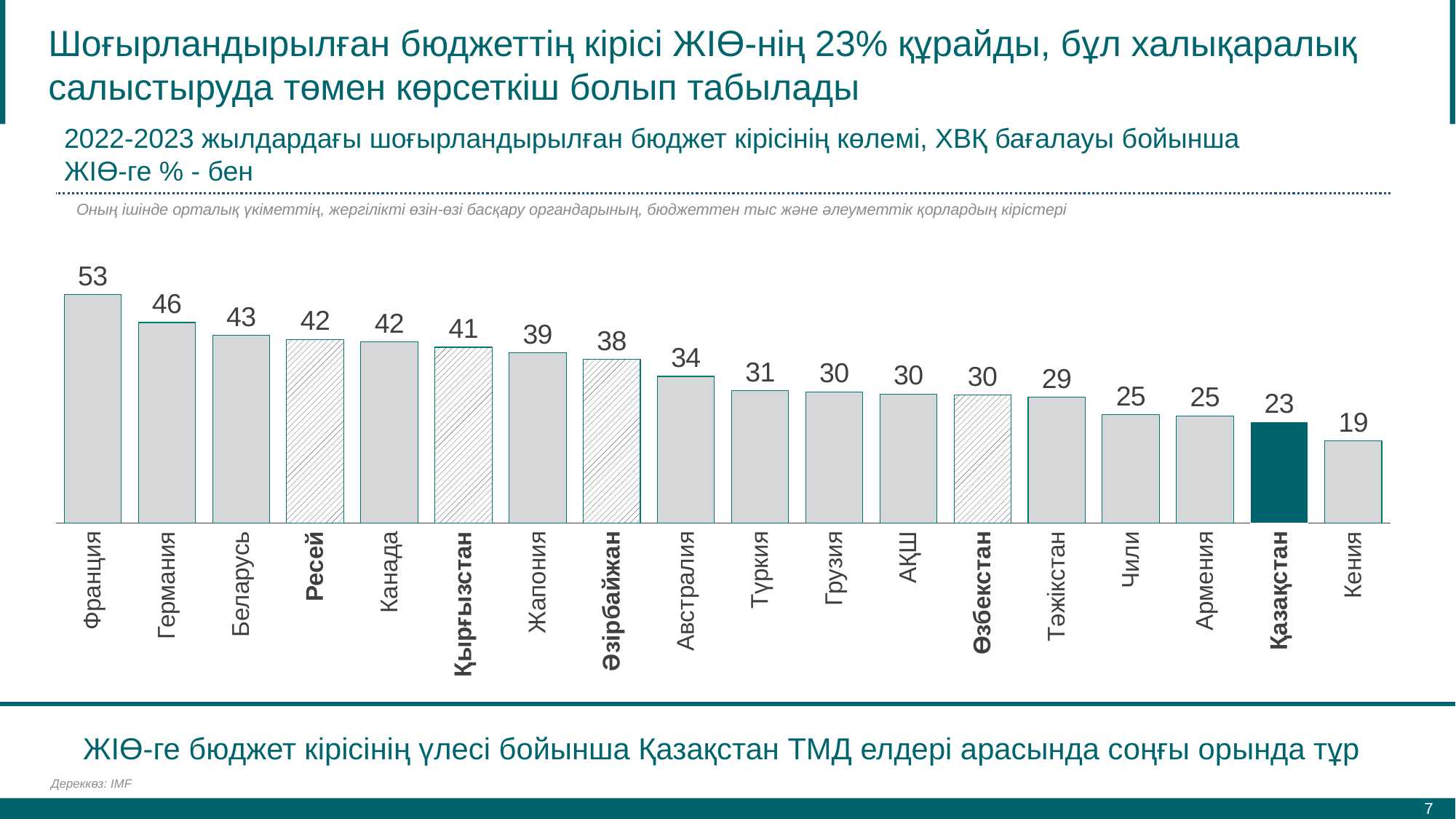
Which country has the highest value in the chart? Франция What is the value shown for Әзірбайжан? 38 Which has a larger value, Тәжікстан or Чили? Тәжікстан Which has a larger value, Жапония or Австралия? Жапония What kind of chart is shown on the slide? Bar chart Do the values rise or fall from left to right across the chart? Fall What is the difference between the values for Франция and Қазақстан? 30 What is the value shown for Франция? 53 What is the value shown for Қазақстан? 23 Which country has the lowest value in the chart? Кения What is the difference between the values for Германия and Беларусь? 3 How many countries are shown in the chart? 18